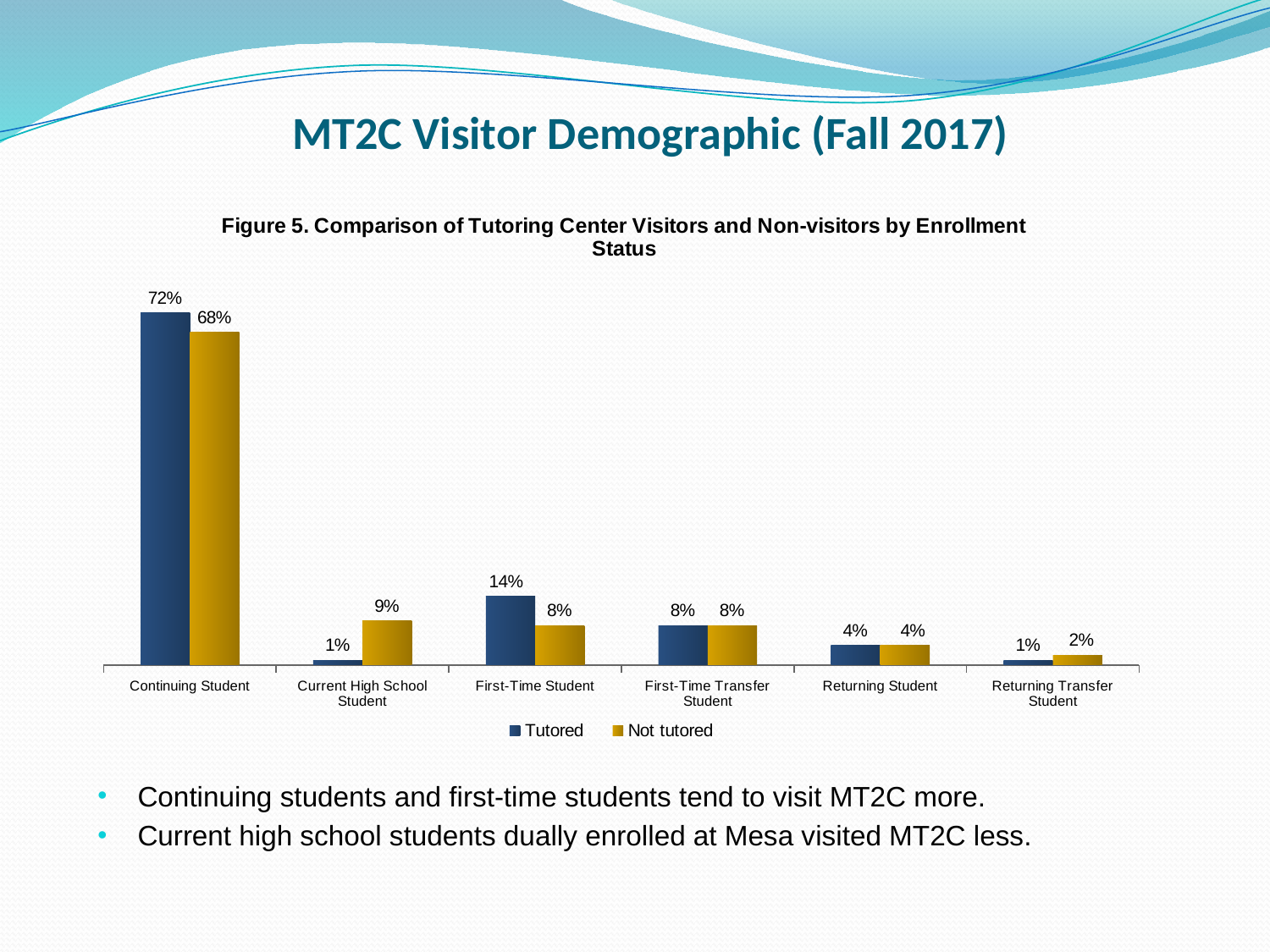
Which category has the lowest Not tutored value? Returning Transfer Student Which is larger for First-Time Student, the Tutored value or the Not tutored value? Tutored How many enrollment status categories are shown on the x axis? 6 What is the difference between the Tutored and Not tutored values for Continuing Student? 4% What is the Not tutored value for Returning Transfer Student? 2% What is the Not tutored value for Current High School Student? 9% How many series does the legend list? 2 What is the Tutored value for First-Time Student? 14% What kind of chart is shown on the slide? Bar chart What is the title of the chart? Figure 5. Comparison of Tutoring Center Visitors and Non-visitors by Enrollment Status Which category has the highest Tutored value? Continuing Student What is the Tutored value for Continuing Student? 72%